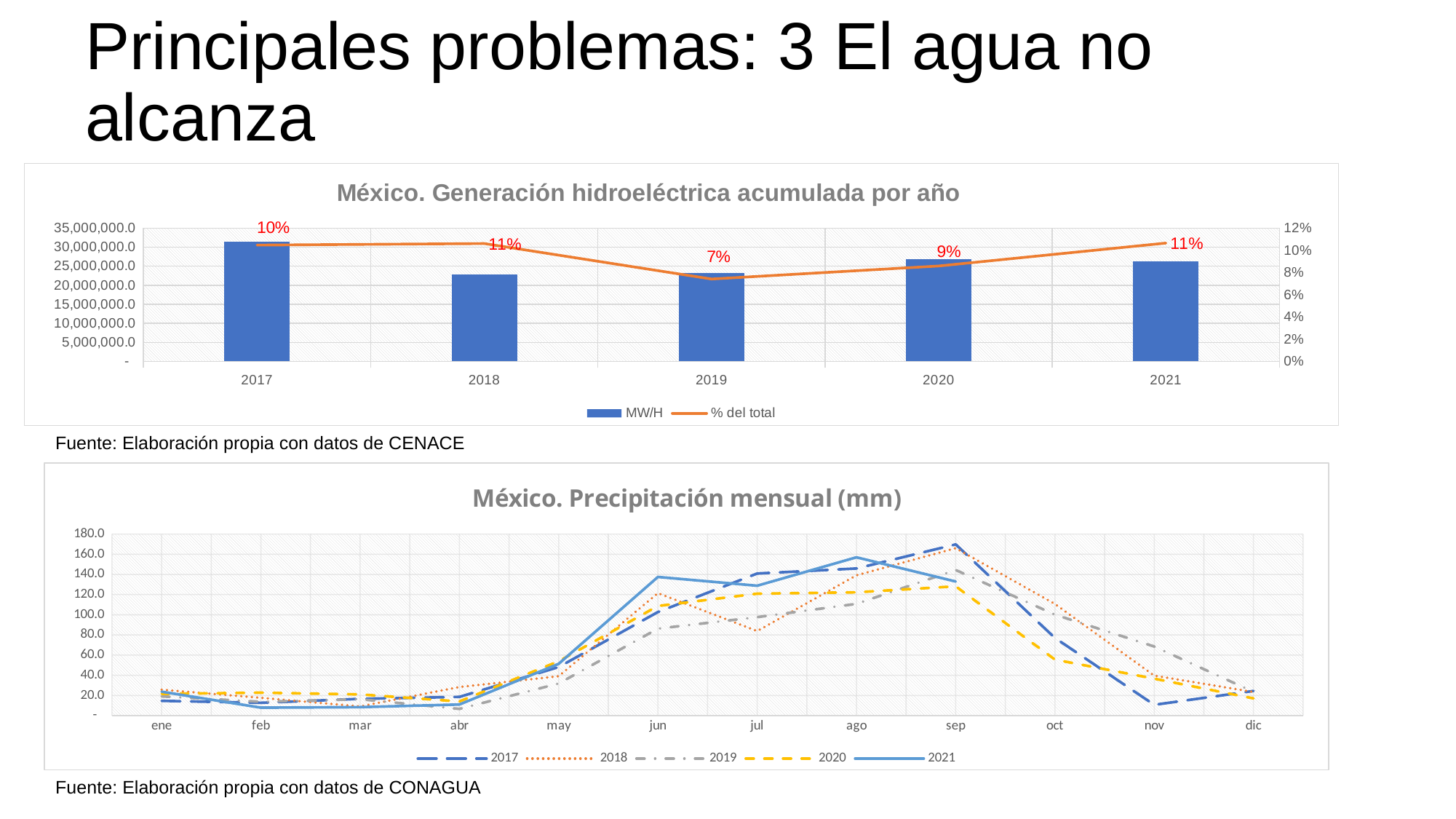
In the chart 'México. Generación hidroeléctrica acumulada por año', which year has the lowest '% del total'? 2019 In the chart 'México. Generación hidroeléctrica acumulada por año', is the MW/H value for 2018 greater or less than 25,000,000.0? less How many series does the legend of the chart 'México. Generación hidroeléctrica acumulada por año' list? 2 In the chart 'México. Generación hidroeléctrica acumulada por año', what is the difference between the '% del total' for 2018 and 2019? 4% In the chart 'México. Generación hidroeléctrica acumulada por año', which is larger, the '% del total' for 2020 or for 2019? 2020 In the chart 'México. Generación hidroeléctrica acumulada por año', what is the '% del total' value for 2017? 10% In the chart 'México. Precipitación mensual (mm)', is the value for 2021 in jun greater or less than 120.0? greater In the chart 'México. Generación hidroeléctrica acumulada por año', which year has the tallest MW/H bar? 2017 In the chart 'México. Generación hidroeléctrica acumulada por año', what is the '% del total' value for 2019? 7% What kind of chart is 'México. Precipitación mensual (mm)'? line chart How many months are shown on the x axis of the chart 'México. Precipitación mensual (mm)'? 12 How many series does the legend of the chart 'México. Precipitación mensual (mm)' list? 5